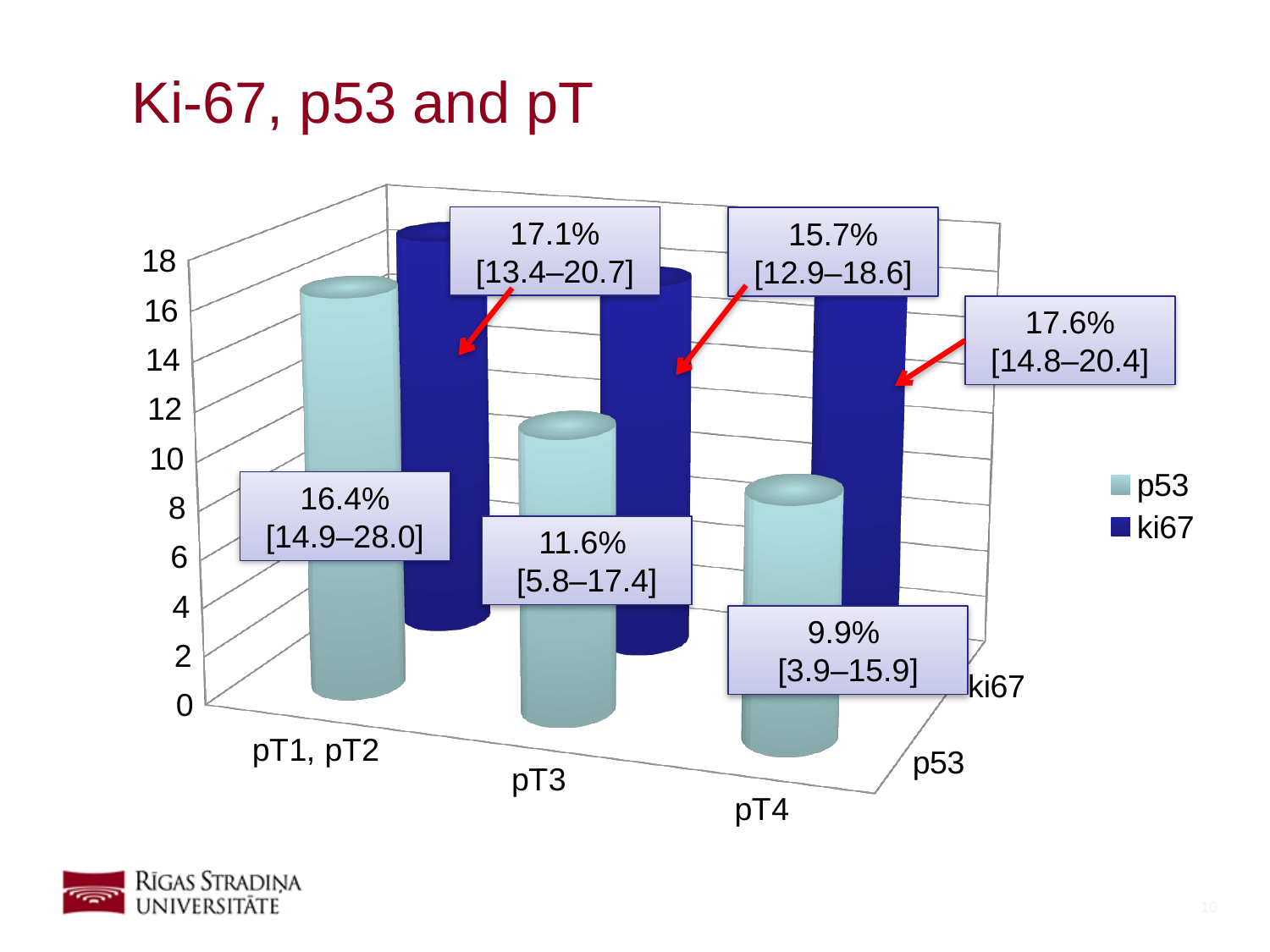
What is the p53 value for pT4? 9.9% What is the p53 value for pT1, pT2? 16.4% Do the p53 values rise or fall from pT1, pT2 to pT4? fall What kind of chart is shown on the slide? bar chart What is the ki67 value for pT3? 15.7% What confidence interval is shown for the ki67 value at pT4? [14.8–20.4] Which pT category has the lowest ki67 value? pT3 How many series does the legend list? 2 Which pT category has the lowest p53 value? pT4 At pT4, which series has the larger value, p53 or ki67? ki67 What is the difference between the p53 values for pT1, pT2 and pT4? 6.5 percentage points Which pT category has the highest p53 value? pT1, pT2